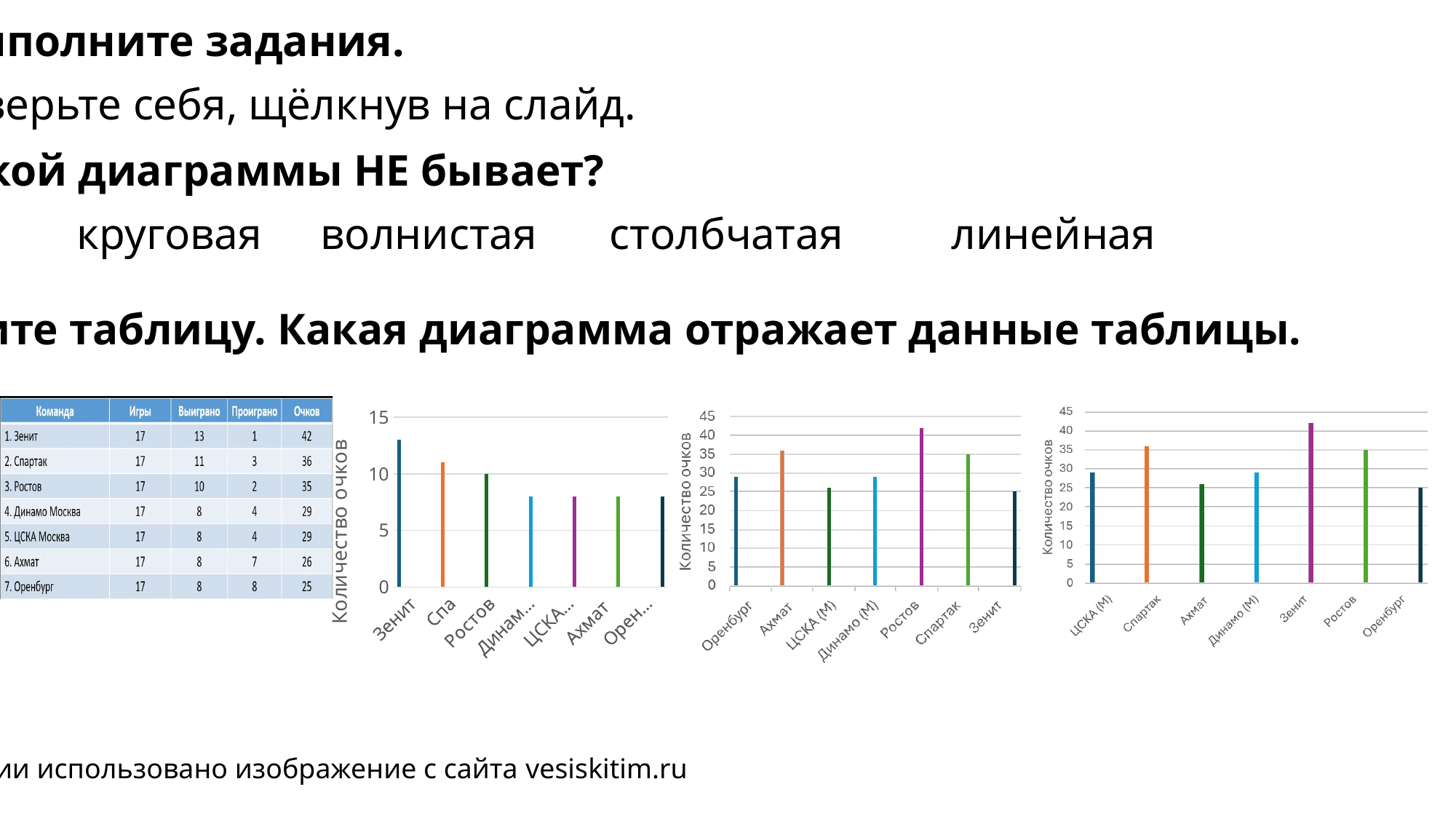
In the left chart, which category has the highest value? Зенит What kind of chart is the left chart on the slide? bar chart In the middle chart, is the value for Ростов greater or less than 40? greater In the right chart, which category has the highest value? Зенит In the right chart, which is larger, the value for Спартак or the value for Ахмат? Спартак In the middle chart, which category has the highest value? Ростов In the left chart, is the value for Ахмат greater or less than 10? less What is the y-axis title of the right chart? Количество очков In the left chart, what is the value for Ростов? 10 In the left chart, is the value for Зенит greater or less than 10? greater In the right chart, which category has the lowest value? Оренбург How many categories does the right chart show? 7